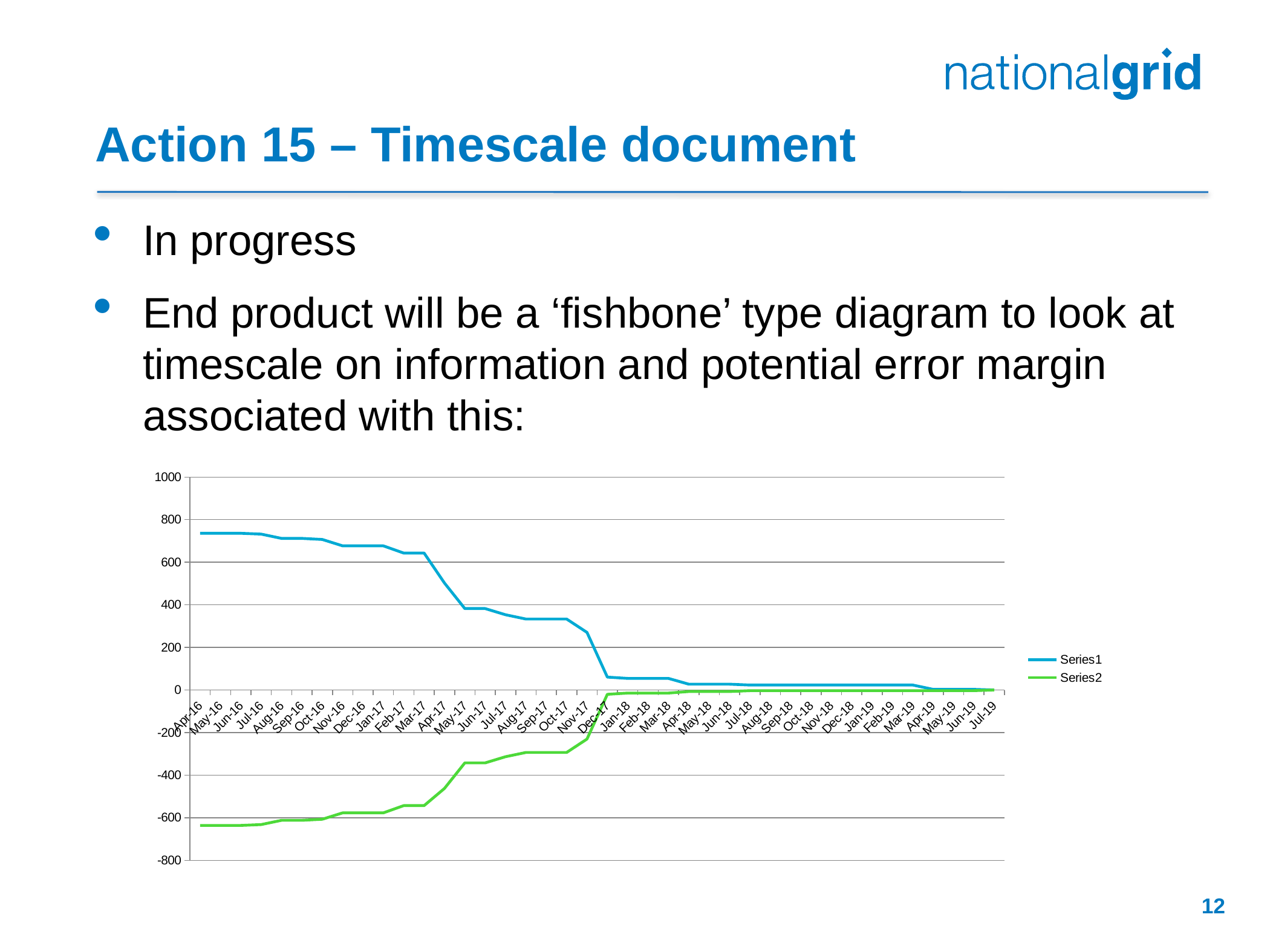
Is the value of Series2 at Apr-16 greater or less than -600? less What kind of chart is shown on the slide? line chart Is the value of Series2 at Jan-17 greater or less than -400? less Is the value of Series1 at Apr-16 greater or less than 600? greater How many series does the chart legend list? 2 Which series is drawn in green in the chart? Series2 Does Series2 rise or fall from Apr-16 to Jul-19? rise How many monthly points are plotted along the x axis of the chart? 40 Does Series1 rise or fall from Apr-16 to Jul-19? fall What is the highest value shown on the chart's y axis? 1000